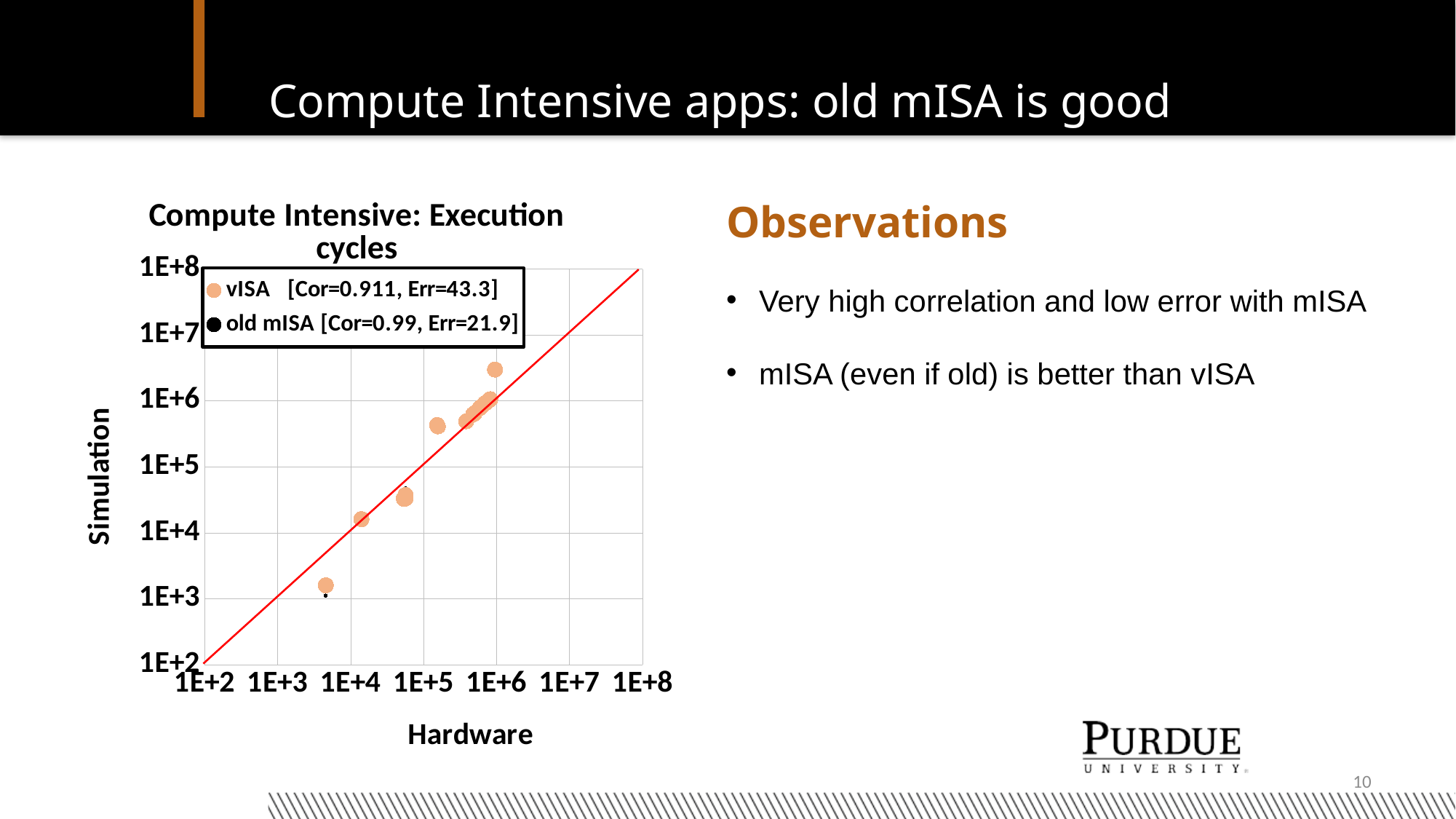
How many series does the chart legend list? 2 Is the Simulation value of the highest vISA point greater or less than 1E+6? greater What correlation value is given for old mISA in the legend? 0.99 Which series has the higher correlation value, vISA or old mISA? old mISA What correlation value is given for vISA in the legend? 0.911 What is the title of the chart? Compute Intensive: Execution cycles What kind of chart is shown on the slide? scatter chart What error value is given for old mISA in the legend? 21.9 What error value is given for vISA in the legend? 43.3 Do the Simulation values rise or fall as the Hardware values increase along the x axis? rise Which series has the lower error value, vISA or old mISA? old mISA What are the x-axis and y-axis labels of the chart? Hardware (x-axis), Simulation (y-axis)